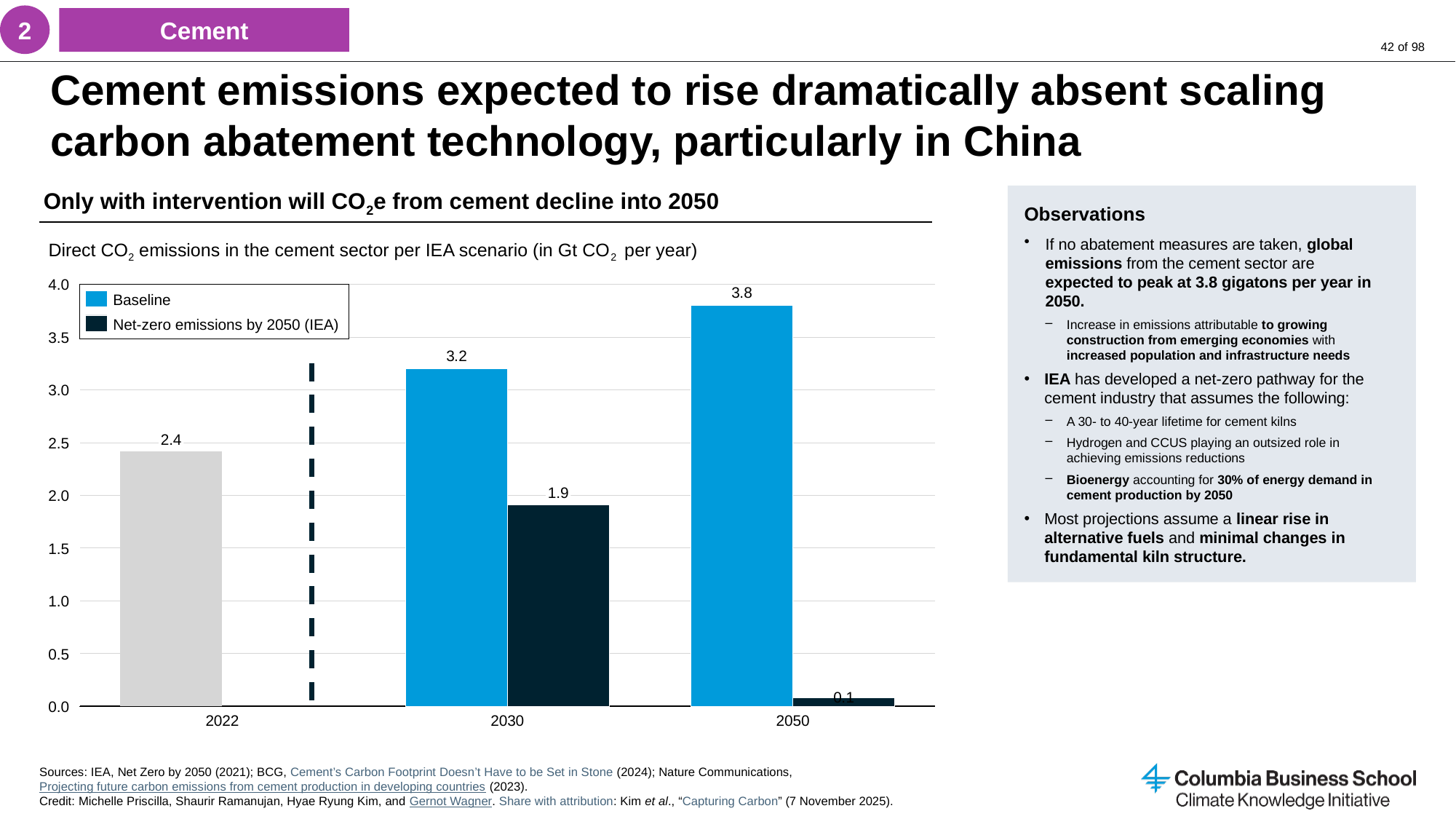
What is the Net-zero emissions by 2050 (IEA) value for 2030? 1.9 What is the Baseline value for 2050? 3.8 What is the Baseline value for 2030? 3.2 By how much does the Baseline value rise from 2030 to 2050? 0.6 Which year has the highest Baseline value? 2050 How many series does the legend list? 2 How many years are shown on the x axis? 3 What kind of chart is shown on the slide? bar chart Is the Net-zero emissions by 2050 (IEA) value for 2050 greater or less than 0.5? less What is the value shown for 2022? 2.4 What is the difference between the Baseline and Net-zero values in 2030? 1.3 In 2030, which is larger: the Baseline value or the Net-zero emissions by 2050 (IEA) value? Baseline